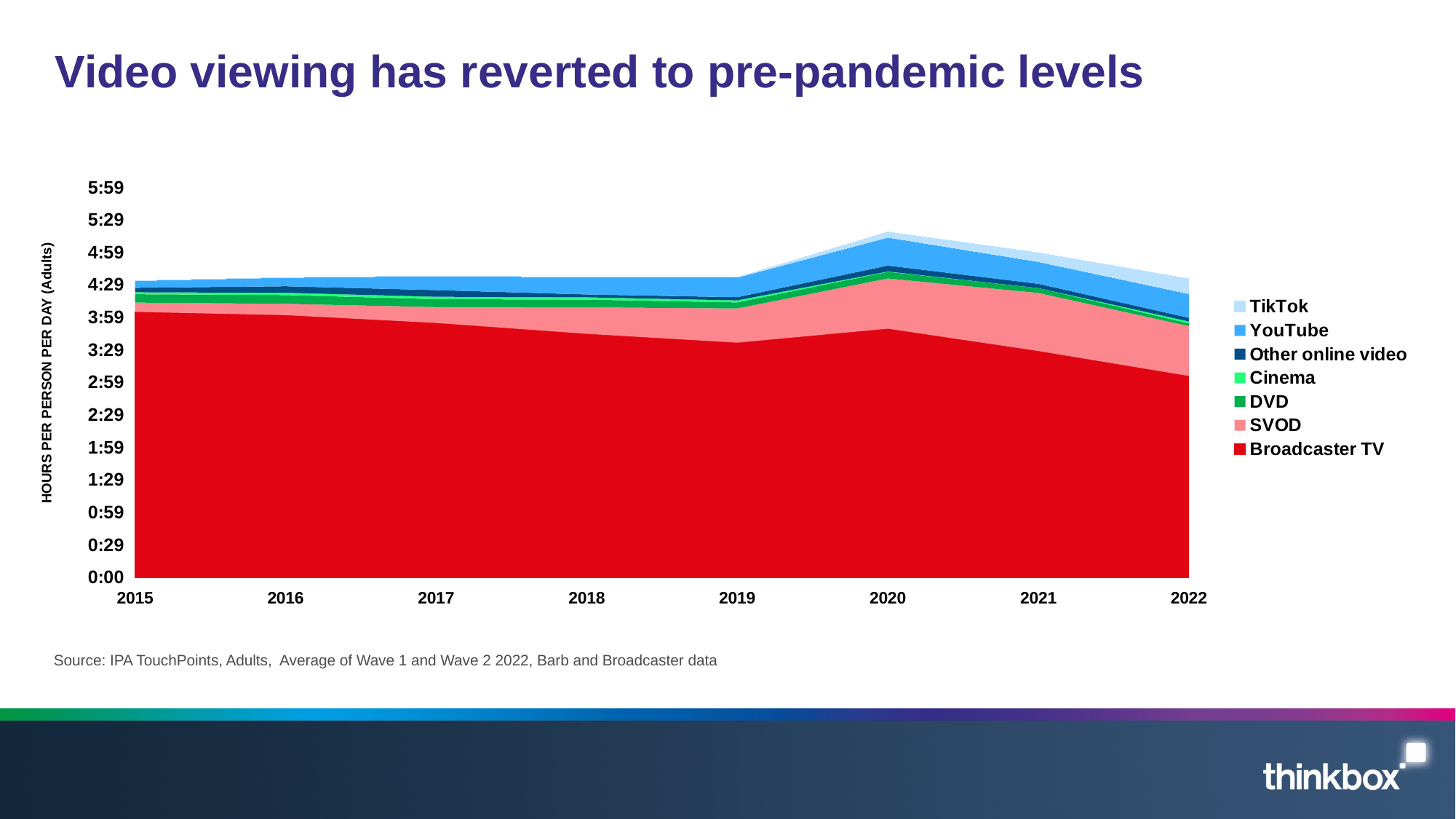
How many series does the legend list? 7 What kind of chart is shown on the slide? Stacked area chart In which year does the total video viewing reach its highest level? 2020 Is the Broadcaster TV value for 2022 greater or less than 3:29? less What is the title of the y axis? HOURS PER PERSON PER DAY (Adults) How many years are plotted along the x axis? 8 Which series forms the bottom layer of the stacked area? Broadcaster TV Is the total video viewing in 2020 greater or less than 4:59? greater In which year is Broadcaster TV viewing at its lowest? 2022 Is the total video viewing in 2015 greater or less than 4:59? less Does Broadcaster TV viewing rise or fall between 2020 and 2022? Fall Which is larger, Broadcaster TV viewing in 2015 or in 2022? 2015